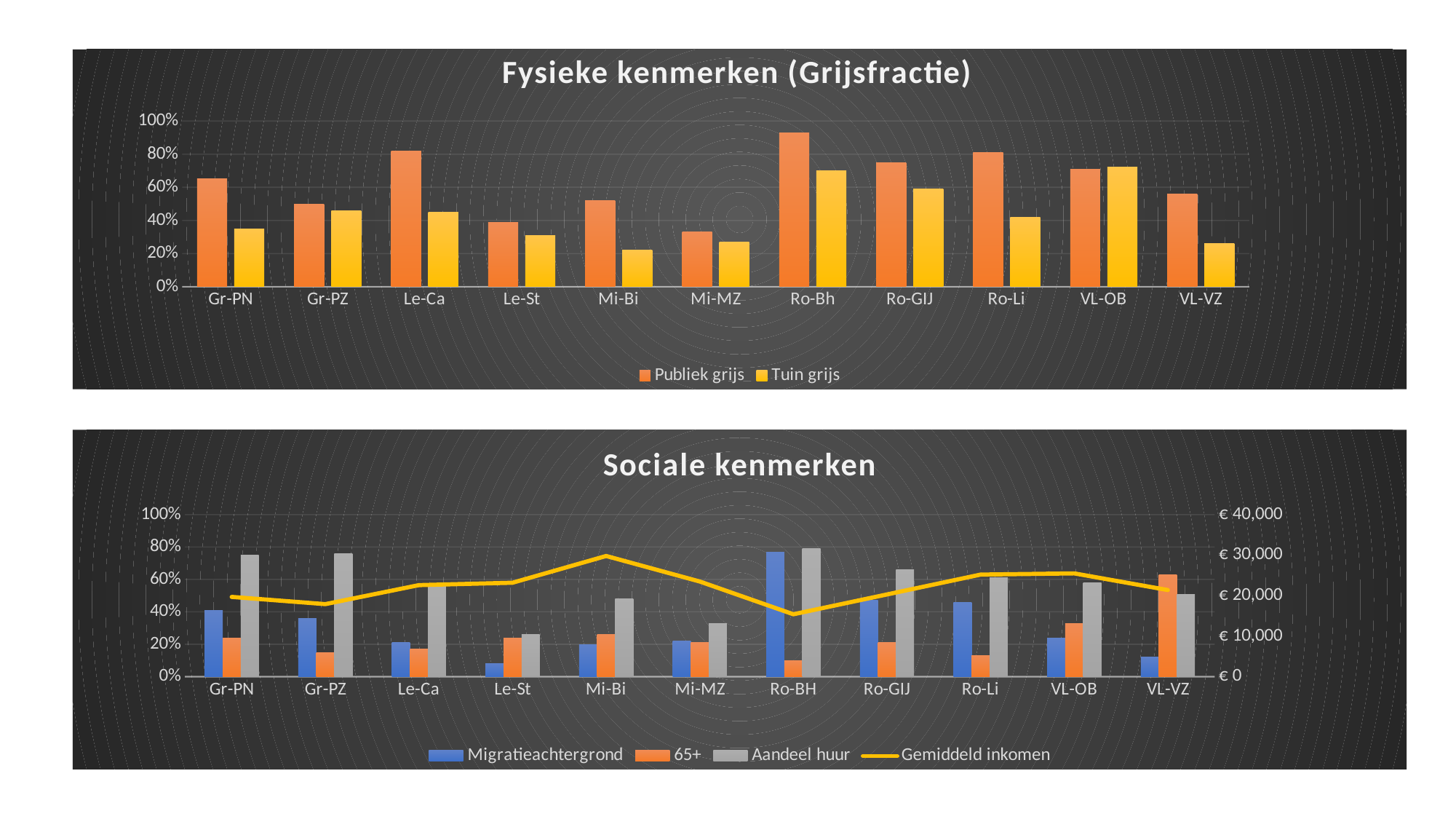
In the top chart 'Fysieke kenmerken (Grijsfractie)', which category has the highest Publiek grijs value? Ro-Bh In the top chart 'Fysieke kenmerken (Grijsfractie)', is the Publiek grijs value for Ro-Bh greater or less than 80%? greater In the top chart 'Fysieke kenmerken (Grijsfractie)', how many categories are shown on the x axis? 11 In the bottom chart 'Sociale kenmerken', is the Gemiddeld inkomen for Mi-Bi greater or less than € 20,000? greater In the top chart 'Fysieke kenmerken (Grijsfractie)', how many series does the legend list? 2 In the bottom chart 'Sociale kenmerken', how many series does the legend list? 4 In the top chart 'Fysieke kenmerken (Grijsfractie)', which category has the lowest Publiek grijs value? Mi-MZ In the bottom chart 'Sociale kenmerken', which category has the highest Migratieachtergrond value? Ro-BH In the top chart 'Fysieke kenmerken (Grijsfractie)', is the Tuin grijs value for Gr-PN greater or less than 40%? less In the top chart 'Fysieke kenmerken (Grijsfractie)', for Gr-PN, which is larger: Publiek grijs or Tuin grijs? Publiek grijs In the bottom chart 'Sociale kenmerken', which category has the lowest Gemiddeld inkomen? Ro-BH What kind of chart is the top chart, 'Fysieke kenmerken (Grijsfractie)'? bar chart